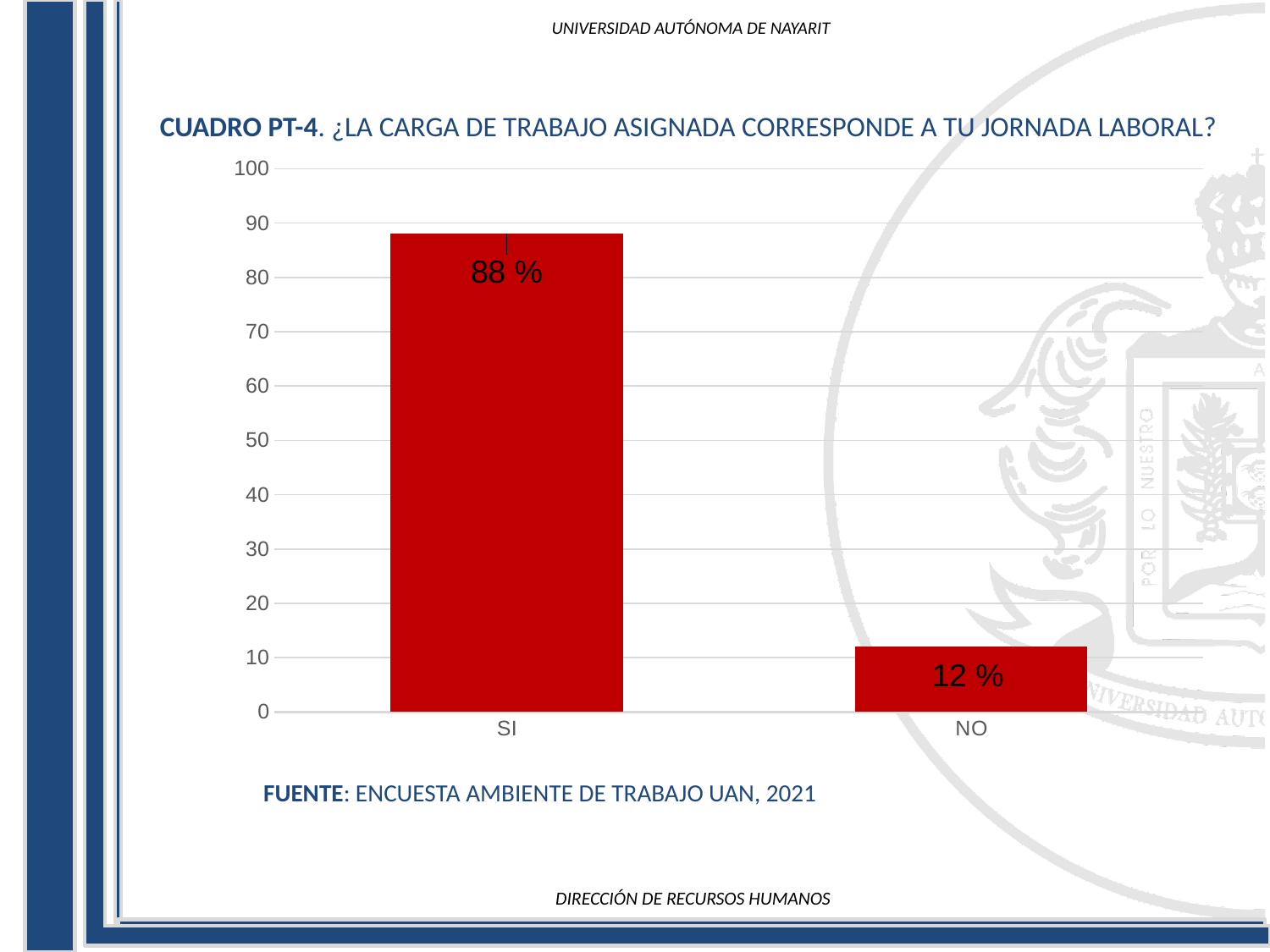
Which is larger, the value for SI or the value for NO? SI Which category has the highest value? SI What kind of chart is shown on the slide? bar chart What source is cited below the chart? ENCUESTA AMBIENTE DE TRABAJO UAN, 2021 How many categories are shown on the x axis? 2 What is the value for NO? 12 % What is the difference between the values for SI and NO? 76 % Is the value for NO greater or less than 20? less Is the value for SI greater or less than 80? greater What is the maximum value shown on the y axis? 100 Which category has the lowest value? NO What is the value for SI? 88 %